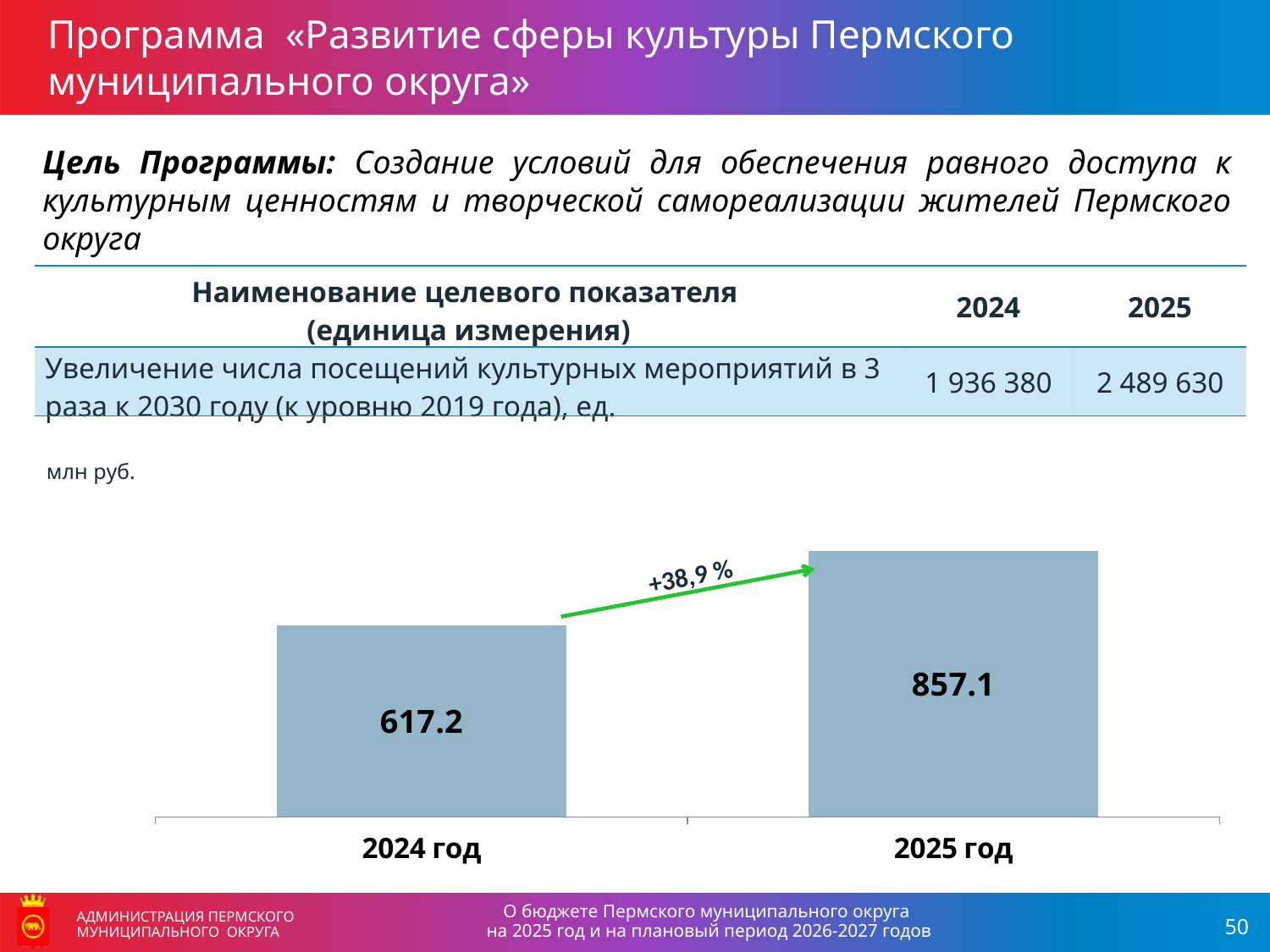
What is the value for 2025 год in the bar chart? 857.1 What is the difference between the values for 2025 год and 2024 год in the bar chart? 239.9 What type of chart is shown on the slide? bar chart Which year has the lowest value in the bar chart? 2024 год How many bars are shown in the chart? 2 Do the values in the chart rise or fall from 2024 год to 2025 год? rise What is the value for 2024 год in the bar chart? 617.2 What unit of measurement is indicated above the chart? млн руб. Which year has the highest value in the bar chart? 2025 год What percentage change is shown on the arrow between the two bars? +38,9 % Which is larger in the bar chart: the value for 2024 год or for 2025 год? 2025 год